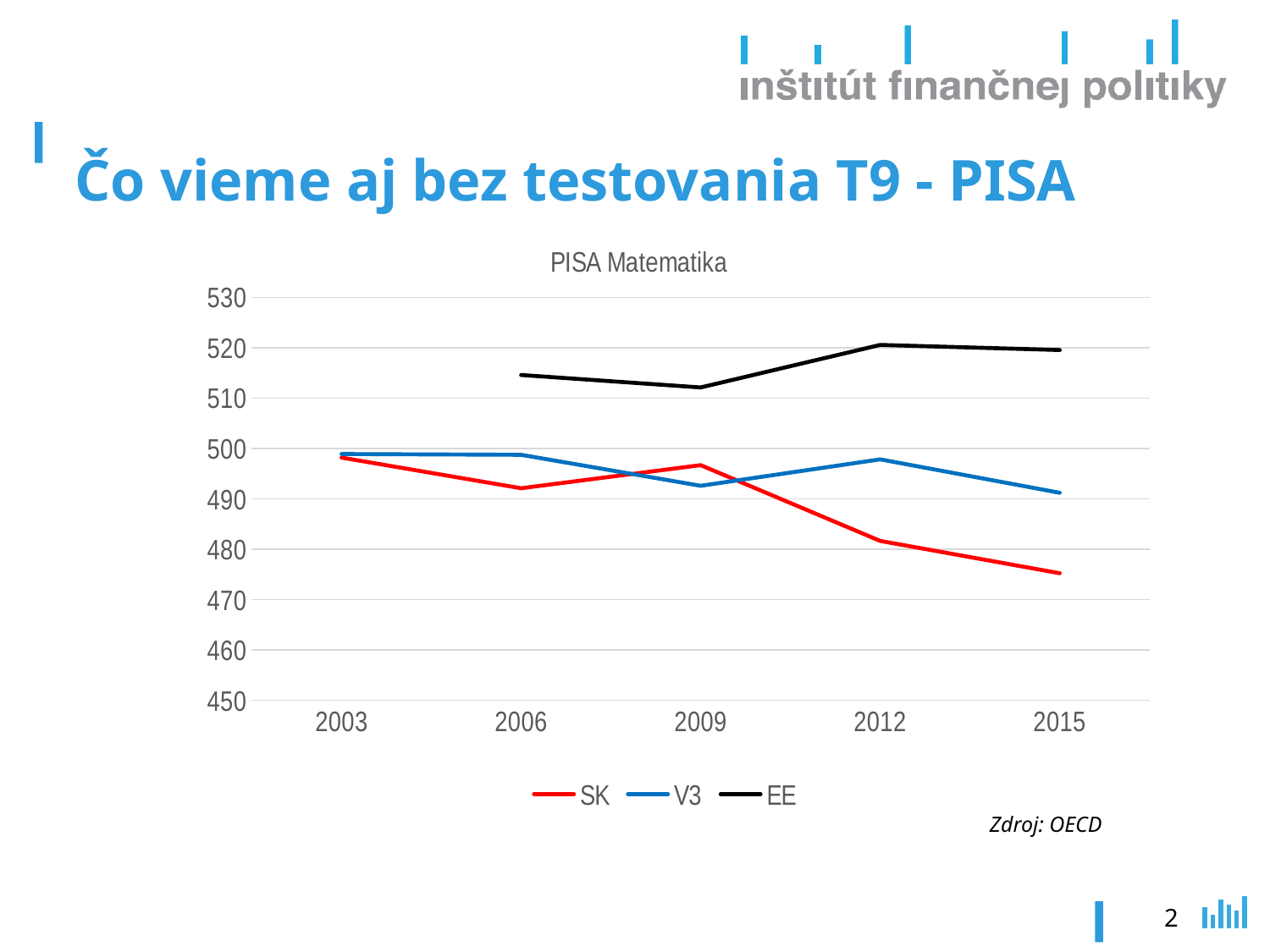
How many years are shown on the x axis? 5 Which series has the lowest value in 2015? SK Which series has the highest value in 2015? EE Does the SK series rise or fall between 2009 and 2015? fall What kind of chart is shown on the slide? line chart Is the value for SK in 2015 greater or less than 480? less Which is larger in 2012, the value for V3 or the value for SK? V3 What source is cited below the chart? OECD Is the value for V3 in 2003 greater or less than 490? greater Is the value for EE in 2012 greater or less than 510? greater How many series does the legend list? 3 What is the title of the chart? PISA Matematika